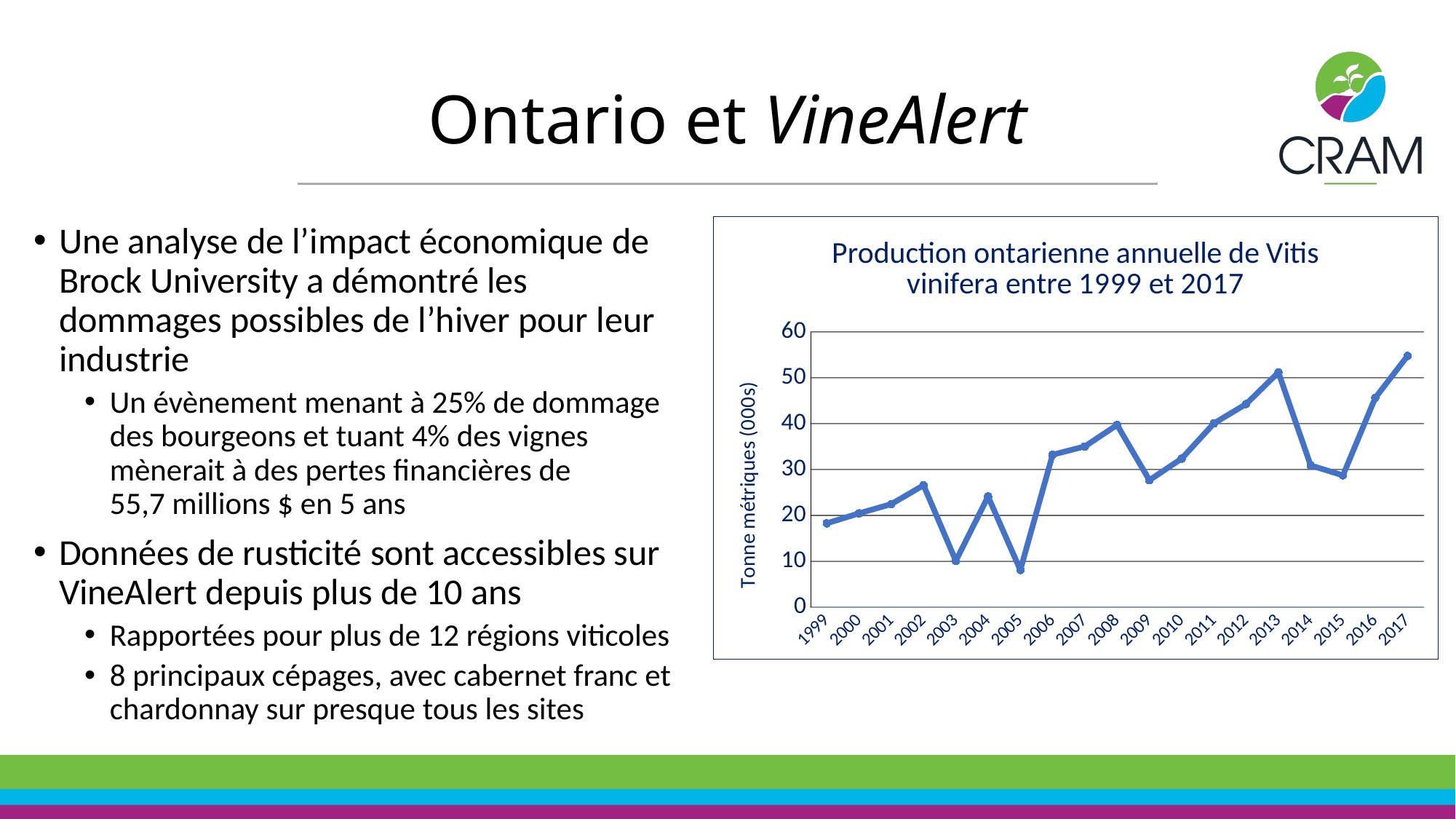
Overall, do the values rise or fall from 1999 to 2017? rise What kind of chart is shown on the slide? line chart Which year has the highest production in the chart? 2017 Is the value for 1999 greater or less than 20? less Is the value for 2003 greater or less than 20? less Which year has the larger value, 2004 or 2005? 2004 Which year has the larger value, 2012 or 2014? 2012 Which year has the lowest production in the chart? 2005 What is the label of the vertical axis of the chart? Tonne métriques (000s) Is the value for 2013 greater or less than 50? greater How many years are plotted on the x axis of the chart? 19